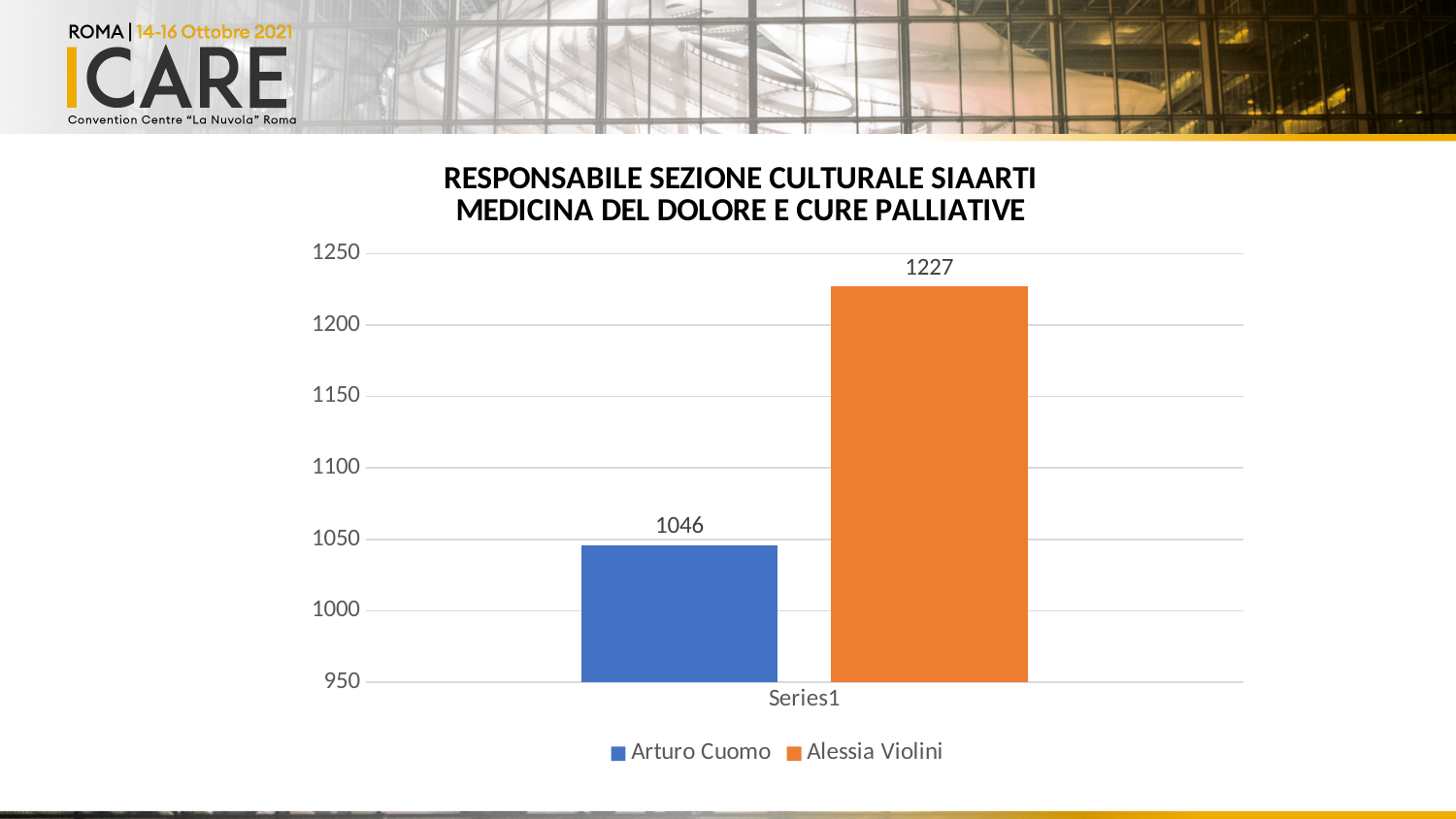
Is the value for Alessia Violini greater or less than 1200? greater What kind of chart is shown on the slide? bar chart What is the title of the chart? RESPONSABILE SEZIONE CULTURALE SIAARTI MEDICINA DEL DOLORE E CURE PALLIATIVE What value is shown for Alessia Violini? 1227 What colour is the bar for Alessia Violini? orange Who has the larger value, Arturo Cuomo or Alessia Violini? Alessia Violini How many series does the legend list? 2 Which candidate has the highest value? Alessia Violini Which candidate has the lowest value? Arturo Cuomo Is the value for Arturo Cuomo greater or less than 1100? less What value is shown for Arturo Cuomo? 1046 What is the difference between the values for Alessia Violini and Arturo Cuomo? 181